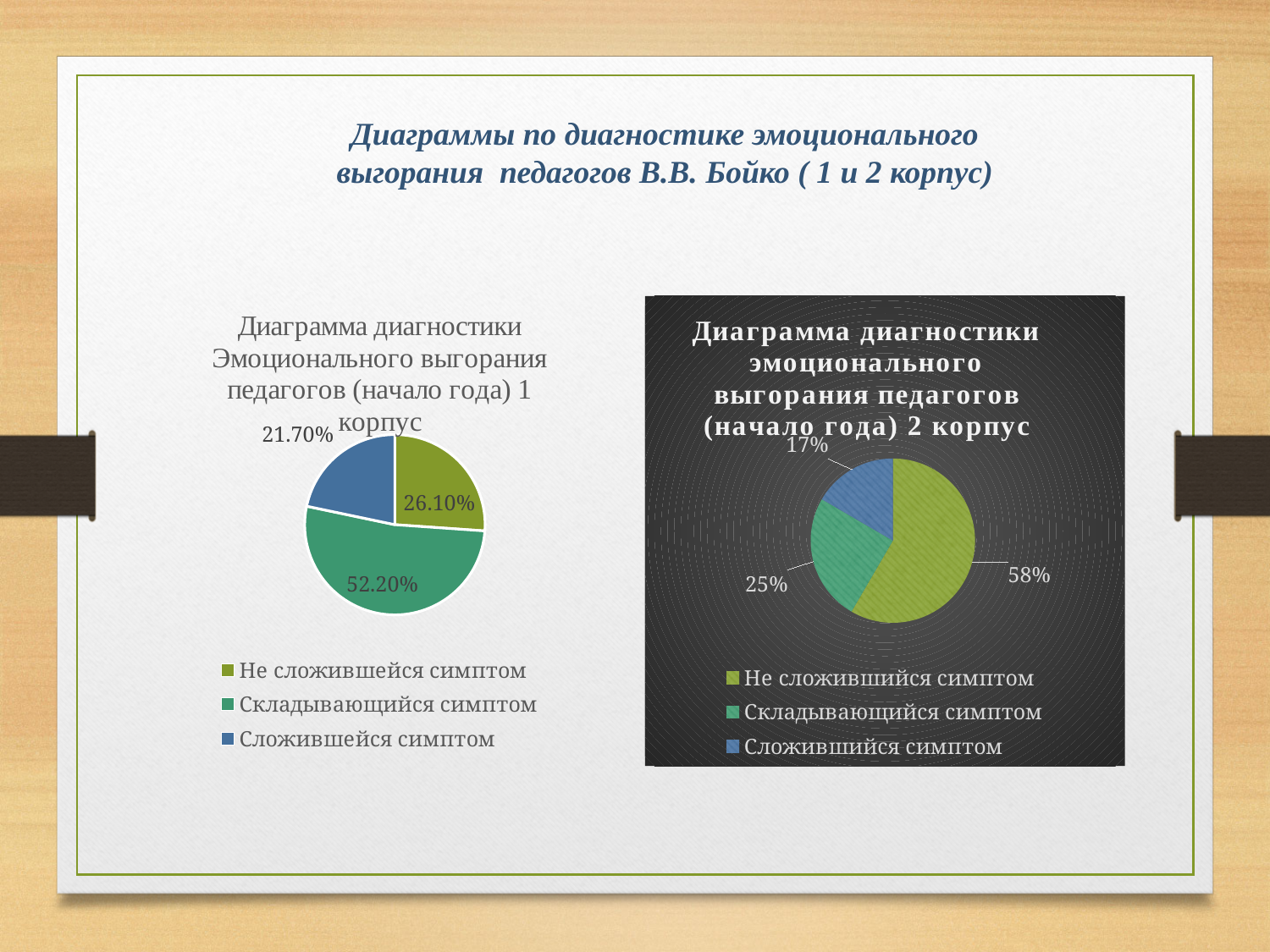
How many slices does the left chart (1 корпус) have? 3 In the left chart (1 корпус), what colour is the slice for "Сложившейся симптом"? Blue In the left chart (1 корпус), what is the value for "Складывающийся симптом"? 52.20% In the right chart (2 корпус), what is the value for "Сложившийся симптом"? 17% In the right chart (2 корпус), which is larger: "Складывающийся симптом" or "Сложившийся симптом"? Складывающийся симптом In the left chart (1 корпус), what is the difference between "Складывающийся симптом" and "Не сложившейся симптом"? 26.10% In the left chart (1 корпус), what is the value for "Сложившейся симптом"? 21.70% In the left chart (1 корпус), which category has the largest share? Складывающийся симптом In the right chart (2 корпус), which category has the smallest share? Сложившийся симптом What type of chart is the right chart (2 корпус)? Pie chart In the right chart (2 корпус), what is the value for "Не сложившийся симптом"? 58% In the right chart (2 корпус), what is the difference between "Не сложившийся симптом" and "Складывающийся симптом"? 33%